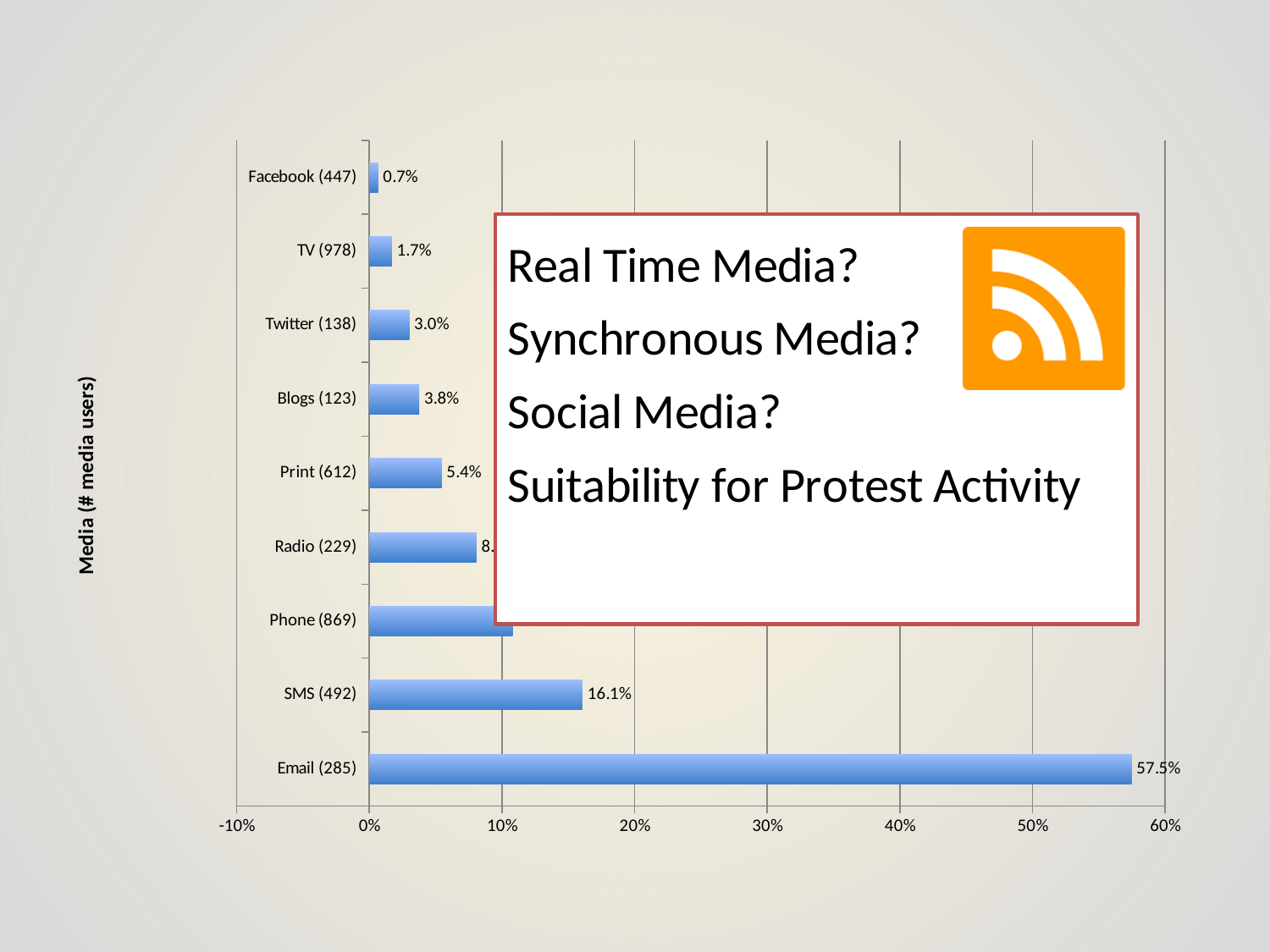
Is the value for Radio (229) greater or less than 10%? less Which is larger, the value for Print (612) or the value for Twitter (138)? Print (612) What is the value for SMS (492)? 16.1% Is the value for Phone (869) greater or less than 20%? less How many categories are shown on the chart? 9 What is the value for Facebook (447)? 0.7% What is the value for Blogs (123)? 3.8% What is the difference between the values for Email (285) and SMS (492)? 41.4% Which category has the highest value? Email (285) What is the value for Email (285)? 57.5% Which category has the lowest value? Facebook (447) What type of chart is shown on the slide? bar chart